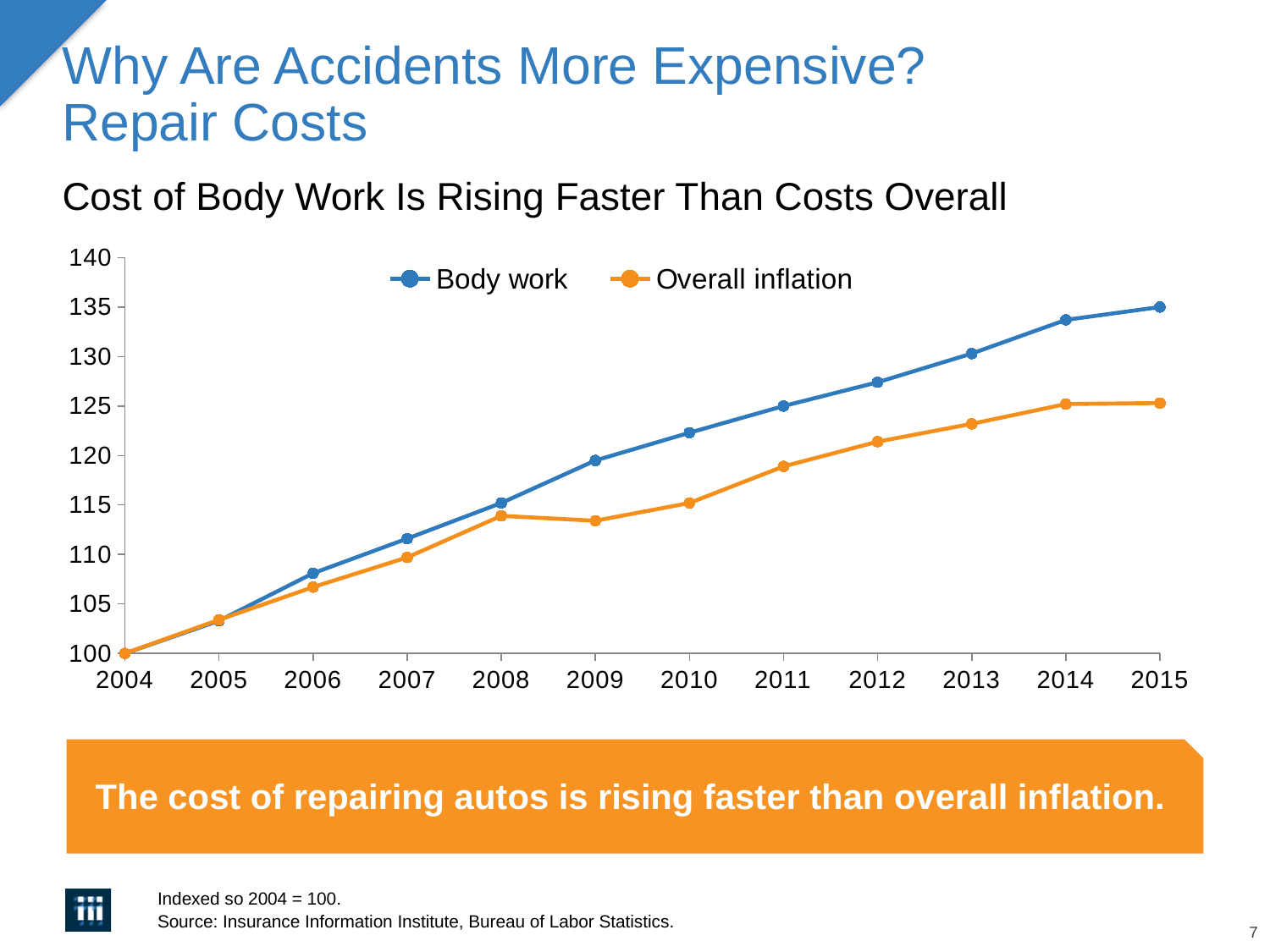
Which series has the larger value in 2015, Body work or Overall inflation? Body work What kind of chart is shown on the slide? line chart What is the value for Body work in 2004? 100 In which year is the Overall inflation series at its lowest? 2004 What colour is the line for Overall inflation? orange What is the value for Overall inflation in 2004? 100 Is the value for Overall inflation in 2009 greater or less than 115? less In which year is the Body work series at its highest? 2015 Is the value for Body work in 2015 greater or less than 130? greater How many years are plotted along the x axis? 12 Does the Body work series rise or fall from 2004 to 2015? rise How many series does the legend list? 2